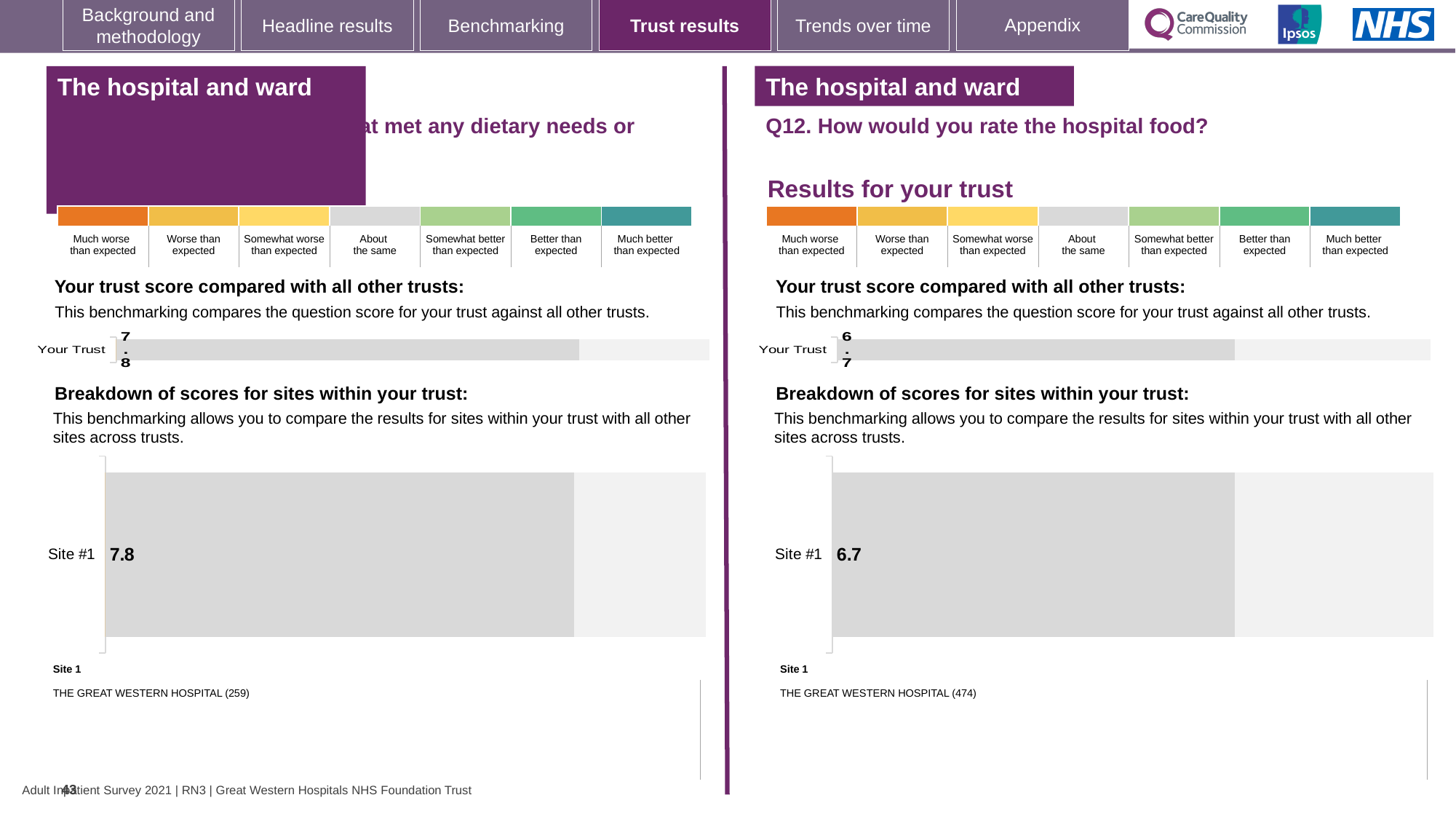
What is the difference between the Your Trust score in the left panel and the Your Trust score in the right panel (Q12)? 1.1 In the left panel, what is the score shown for Your Trust? 7.8 How many sites are shown in the breakdown of scores for sites chart in the right panel (Q12)? 1 In the left panel, what score is shown for Site #1 in the breakdown of scores for sites chart? 7.8 How many bars are plotted in the Your Trust chart in the left panel? 1 Is the Site #1 score in the right panel (Q12) greater or less than the Site #1 score in the left panel? less Which panel shows the higher Your Trust score, the left panel or the right panel (Q12)? Left panel Which site is listed as Site 1 below the breakdown chart in the right panel (Q12)? THE GREAT WESTERN HOSPITAL What is the label of the bar in the Your Trust chart in the right panel (Q12)? Your Trust In the right panel (Q12), what score is shown for Site #1 in the breakdown of scores for sites chart? 6.7 What kind of chart is used to show the Your Trust score in each panel? Bar chart In the right panel (Q12, hospital food), what is the score shown for Your Trust? 6.7